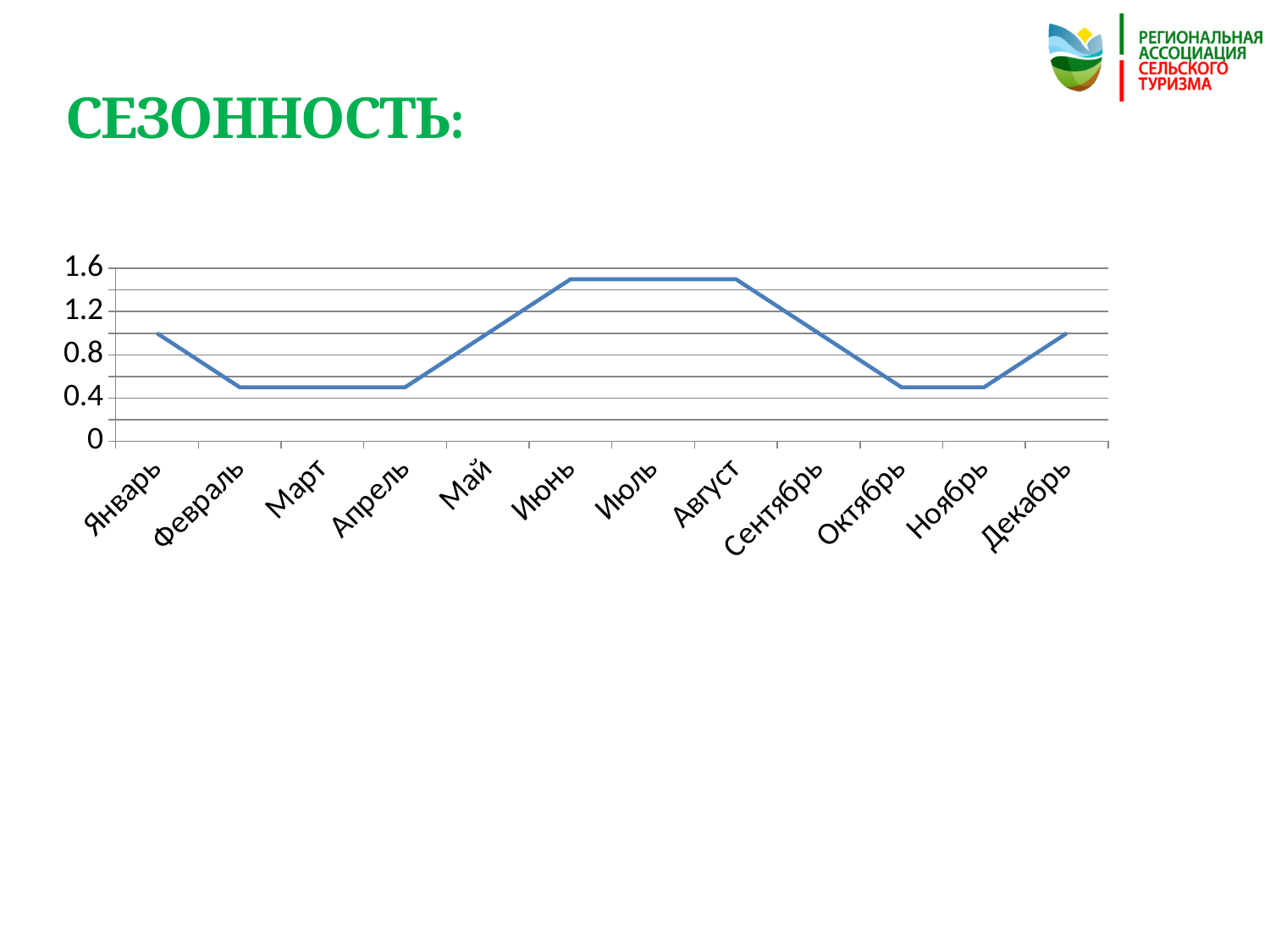
Is the value for Ноябрь greater or less than 0.4? greater What kind of chart is shown on the slide? line chart What is the title of the slide containing the chart? СЕЗОННОСТЬ: Does the line rise or fall from Август to Октябрь? fall How many months are plotted along the x axis of the chart? 12 Is the value for Январь greater or less than 0.8? greater Which is larger, the value for Июль or the value for Март? Июль Is the value for Февраль greater or less than 0.8? less Which is larger, the value for Октябрь or the value for Сентябрь? Сентябрь Does the line rise or fall from Апрель to Июнь? rise